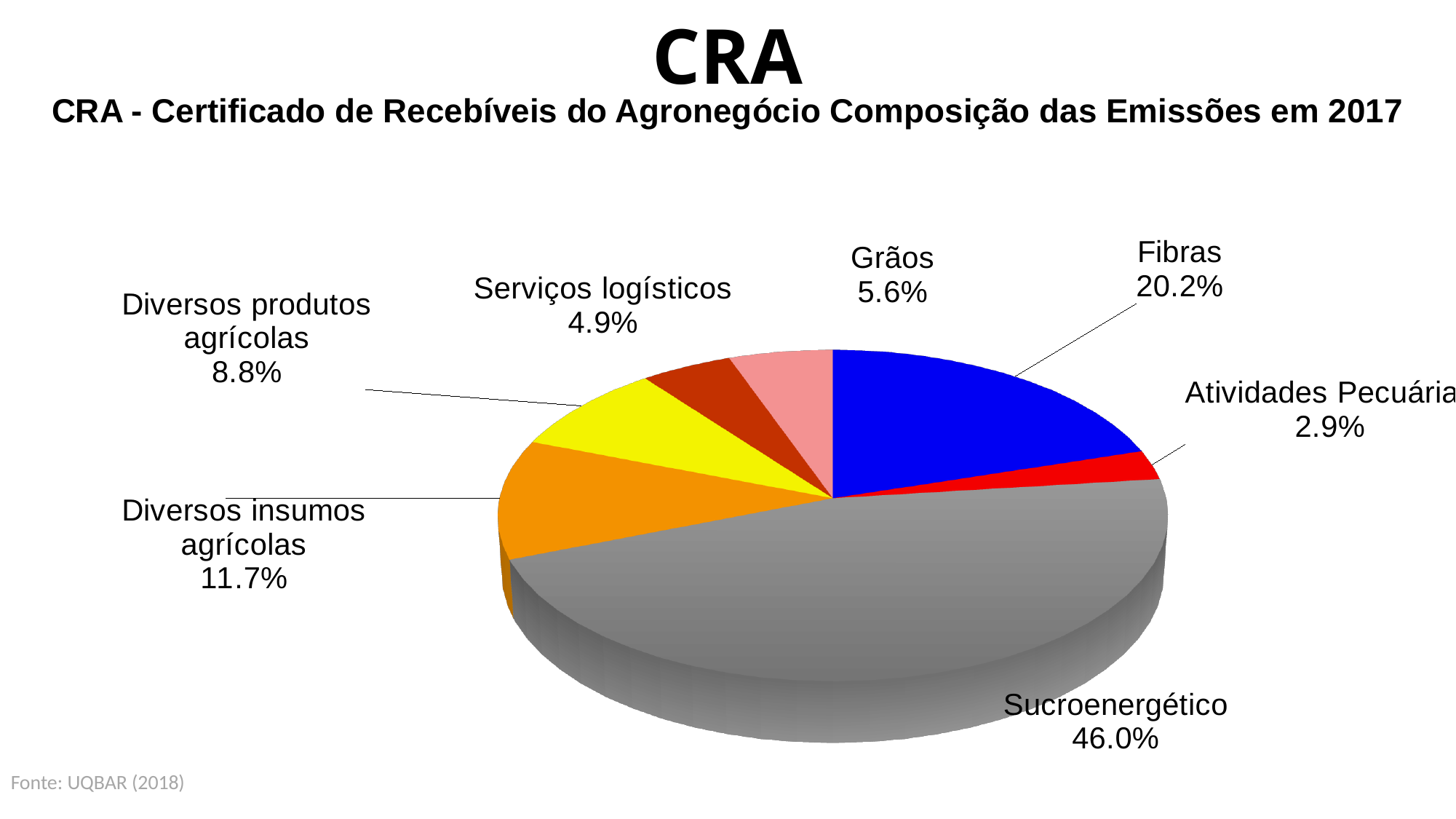
How many categories are shown in the pie chart? 7 What is the percentage shown for Fibras? 20.2% What is the difference in percentage points between Diversos insumos agrícolas and Diversos produtos agrícolas? 2.9 Which category has the largest share of the pie? Sucroenergético Which is larger, Grãos or Serviços logísticos? Grãos What share of CRA emissions in 2017 does Sucroenergético account for? 46.0% Which category has the smallest share of the pie? Atividades Pecuárias What is the percentage shown for Diversos insumos agrícolas? 11.7% What kind of chart is shown on the slide? Pie chart What is the percentage shown for Atividades Pecuárias? 2.9% What is the difference in percentage points between Sucroenergético and Fibras? 25.8 What colour is the Fibras slice? Blue